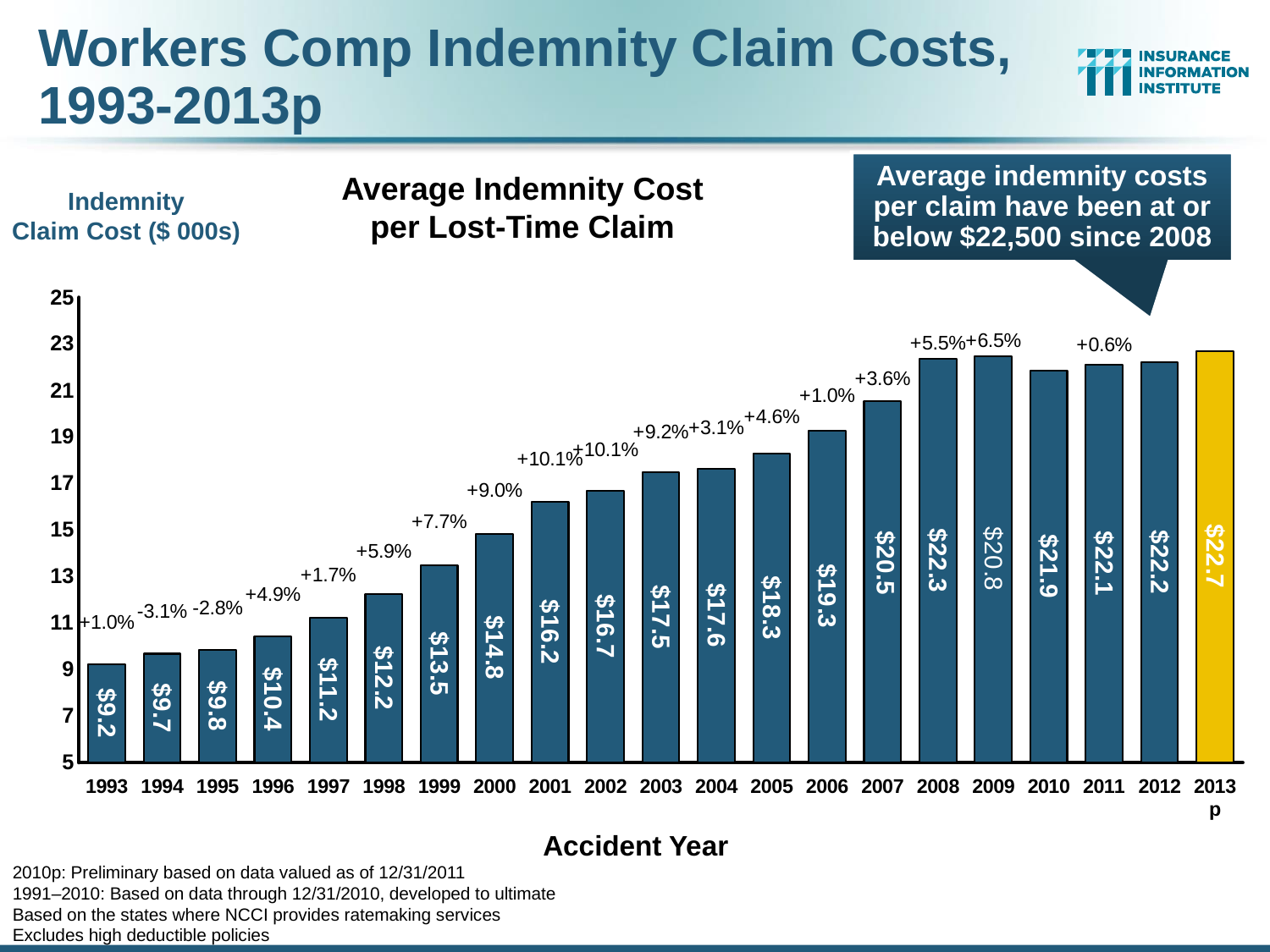
Which accident year has the lowest average indemnity cost per lost-time claim? 1993 What is the difference between the average indemnity cost per claim in 2013p and in 1993? $13.5 What kind of chart is used to show the average indemnity cost per lost-time claim? bar chart Which accident year has the highest average indemnity cost per lost-time claim? 2013p What is the average indemnity cost per lost-time claim for accident year 2013p? $22.7 Which accident year has the larger average indemnity cost per claim, 2005 or 2006? 2006 Is the average indemnity cost per claim for 2003 greater or less than 17? greater What is the average indemnity cost per lost-time claim for accident year 1993? $9.2 How many accident years are plotted in the chart? 21 What percentage change is printed above the bar for accident year 2001? +10.1% Do the average indemnity costs per claim generally rise or fall from 1993 to 2013p? rise What is the average indemnity cost per lost-time claim for accident year 2007? $20.5